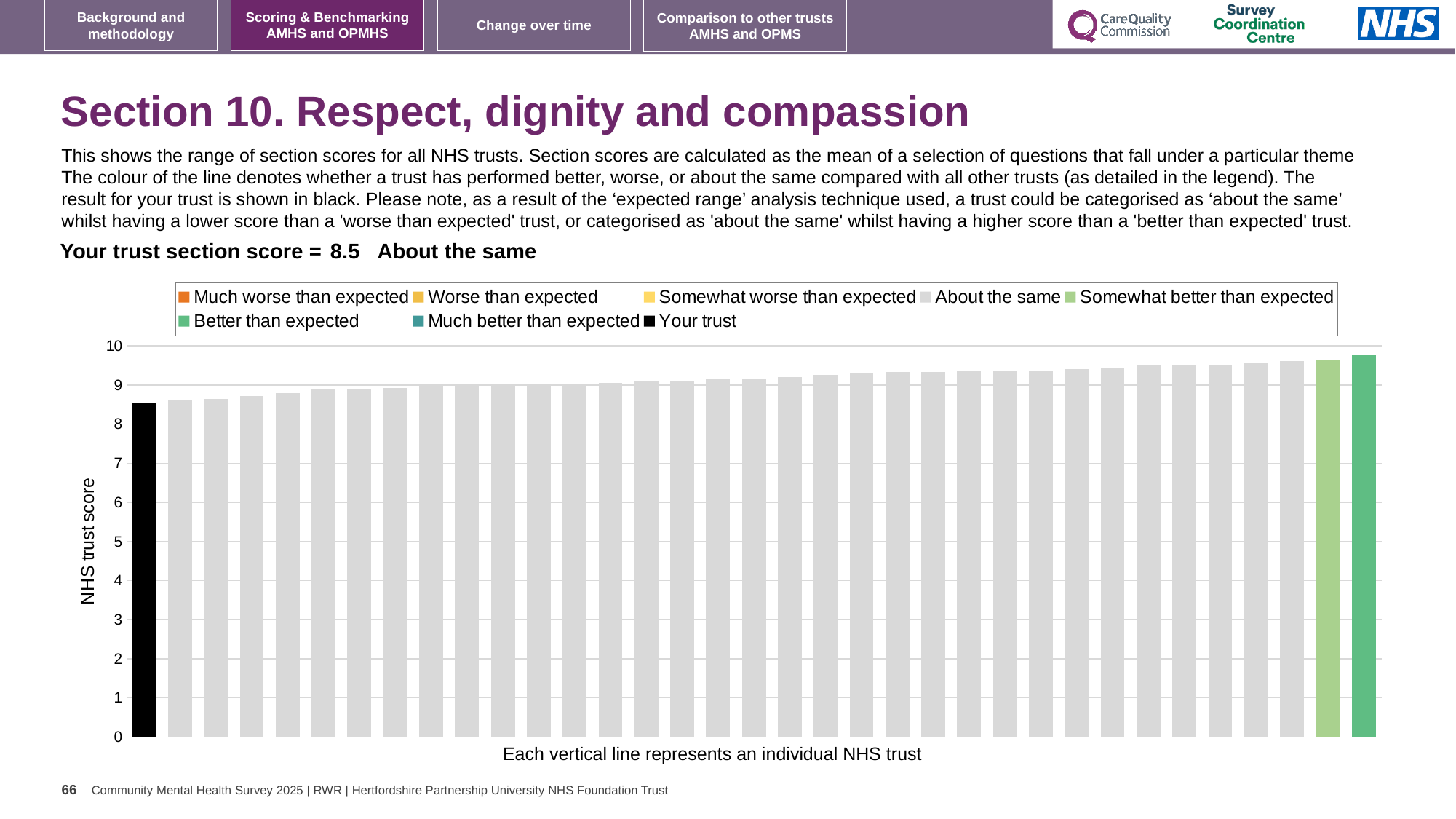
Is the value of the black 'Your trust' bar greater or less than 9? less Do the bar values rise or fall from left to right across the chart? rise Which bar has the lowest score in the chart? Your trust (the black bar) How many bars in the chart are coloured green (somewhat better or better than expected)? 2 What colour is the bar representing your trust? black What kind of chart is shown on the slide? bar chart What is the label on the vertical axis of the chart? NHS trust score How many entries does the chart legend list? 8 What is the section score for your trust shown on the slide? 8.5 Is the value of the tallest bar on the far right greater or less than 9? greater Which legend category does the tallest bar on the far right belong to? Better than expected Which category is your trust's section score placed in? About the same